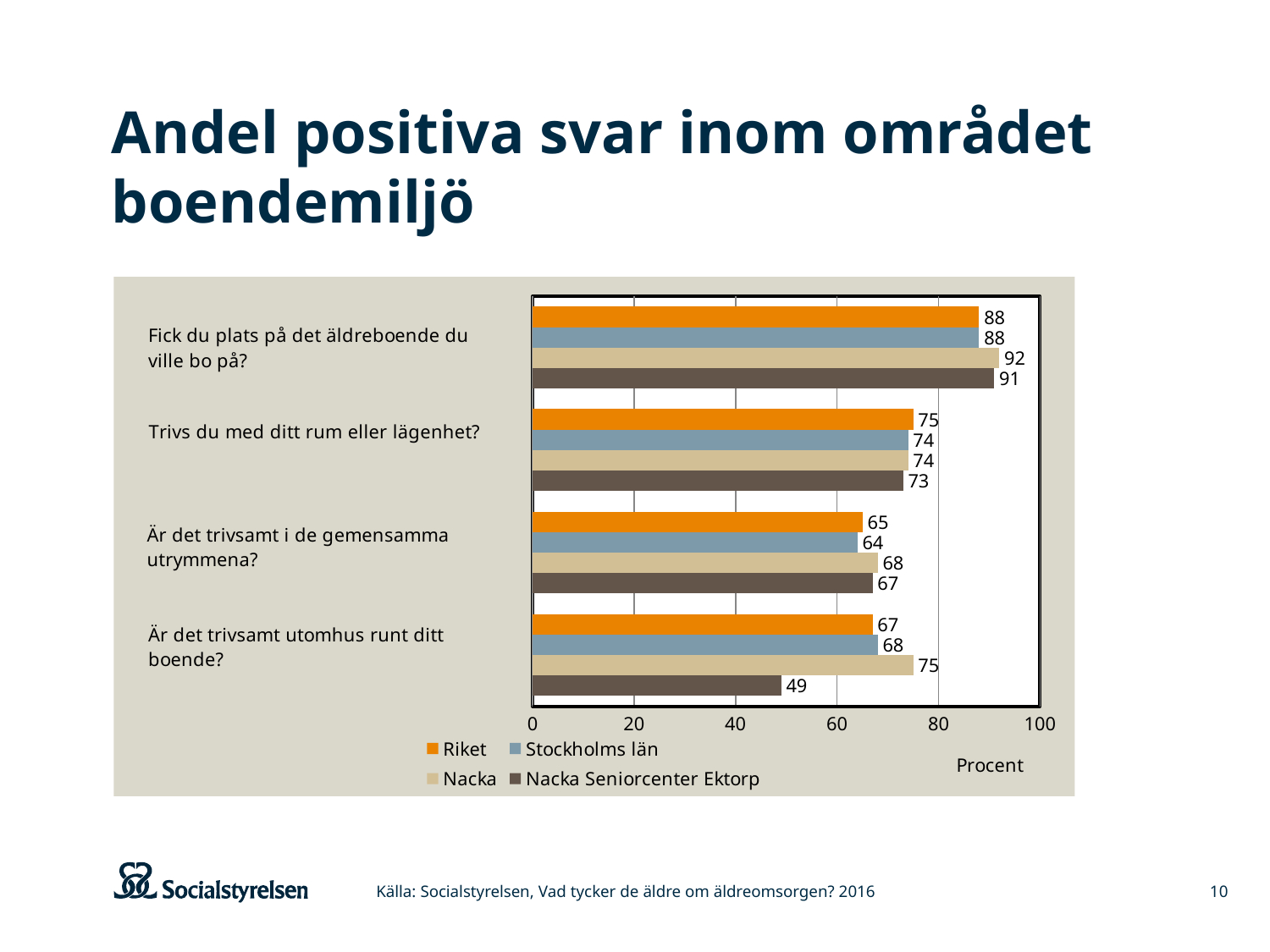
How many series does the legend list? 4 What is the difference between the Nacka value and the Nacka Seniorcenter Ektorp value on "Är det trivsamt utomhus runt ditt boende?"? 26 What is the value for Riket on "Trivs du med ditt rum eller lägenhet?"? 75 Which series has the highest value on "Fick du plats på det äldreboende du ville bo på?"? Nacka What is the value for Nacka on "Fick du plats på det äldreboende du ville bo på?"? 92 What is the label on the horizontal axis of the chart? Procent Which series has the lowest value on "Är det trivsamt utomhus runt ditt boende?"? Nacka Seniorcenter Ektorp What is the value for Stockholms län on "Är det trivsamt i de gemensamma utrymmena?"? 64 How many question categories are shown on the chart? 4 Which is larger on "Är det trivsamt i de gemensamma utrymmena?": the value for Nacka or the value for Riket? Nacka What kind of chart is shown on the slide? Bar chart What is the value for Nacka Seniorcenter Ektorp on "Är det trivsamt utomhus runt ditt boende?"? 49